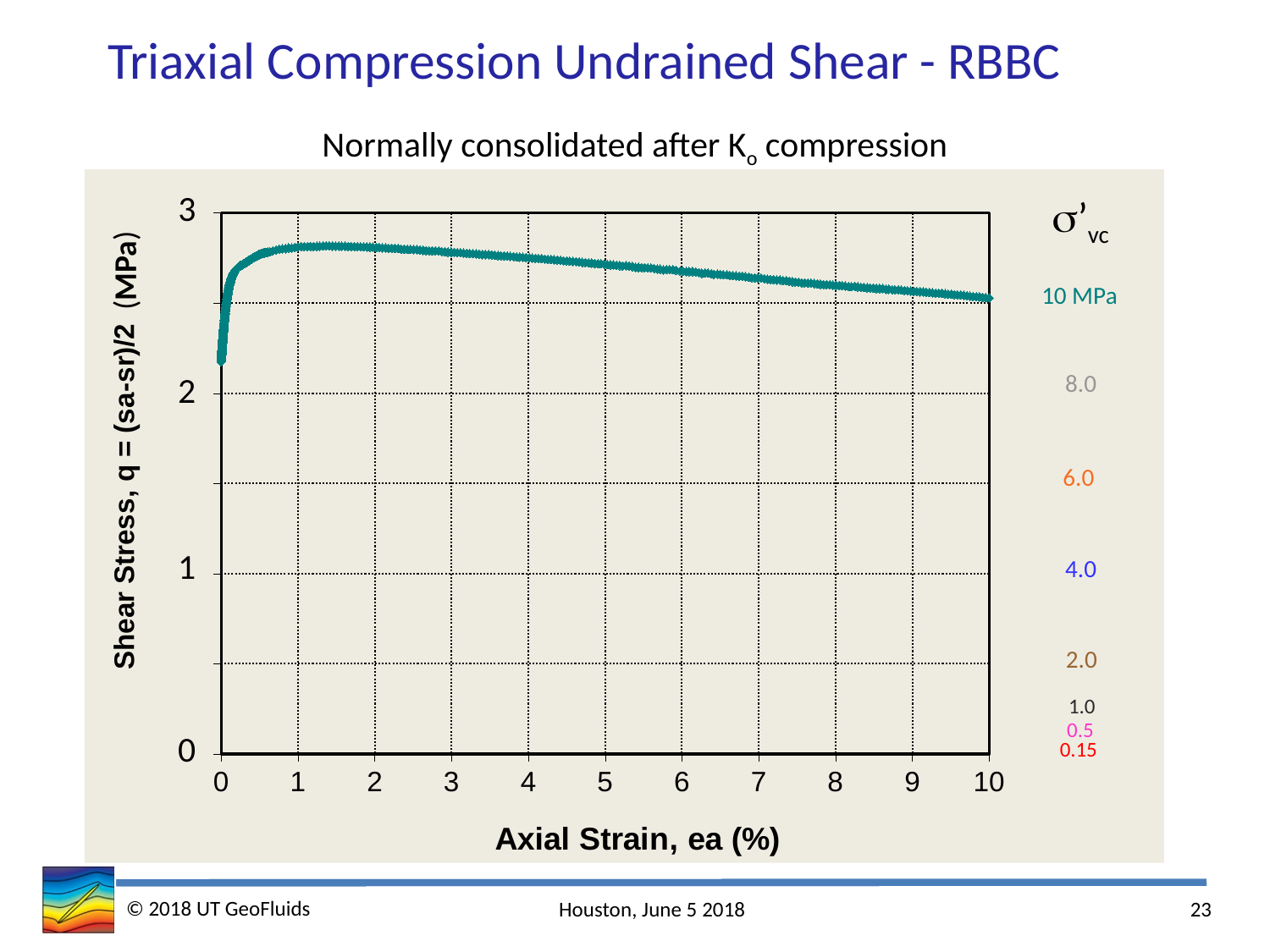
Is the shear stress at an axial strain of 10% greater or less than 2 MPa? greater Is the shear stress at an axial strain of 2% larger or smaller than at 10%? larger What is the maximum value shown on the x axis? 10 Is the shear stress at an axial strain of 0% greater or less than 2 MPa? greater What is the label of the x axis? Axial Strain, ea (%) What is the title of the chart? Normally consolidated after Ko compression How many curves are plotted on the chart? 1 Is the peak shear stress of the plotted curve greater or less than 3 MPa? less How many σ'vc values does the legend on the right list? 8 What kind of chart is shown on the slide? line chart Which σ'vc value does the plotted teal curve correspond to? 10 MPa Between an axial strain of 2% and 10%, does the shear stress rise or fall? fall